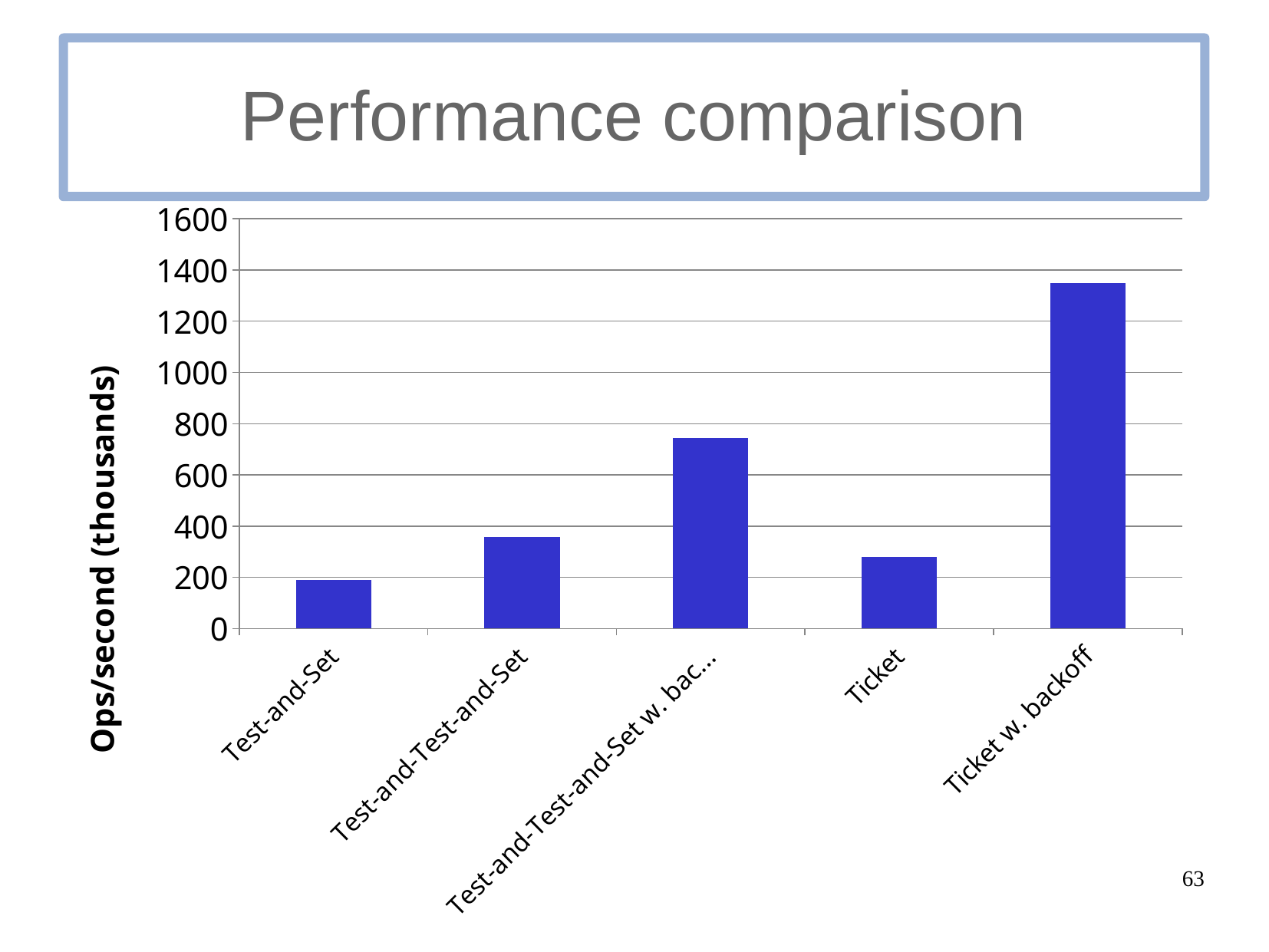
How many categories (bars) are shown in the chart? 5 Which is larger, the value for Ticket or the value for Test-and-Test-and-Set? Test-and-Test-and-Set Which category has the highest value? Ticket w. backoff Is the value for Ticket w. backoff greater or less than 1200? greater Which category has the lowest value? Test-and-Set Which is larger, the value for Test-and-Set or the value for Ticket? Ticket Is the value for Test-and-Test-and-Set greater or less than 200? greater What is the label of the vertical axis? Ops/second (thousands) Is the value for Ticket greater or less than 400? less What is the title of the slide containing the chart? Performance comparison What kind of chart is shown on the slide? bar chart